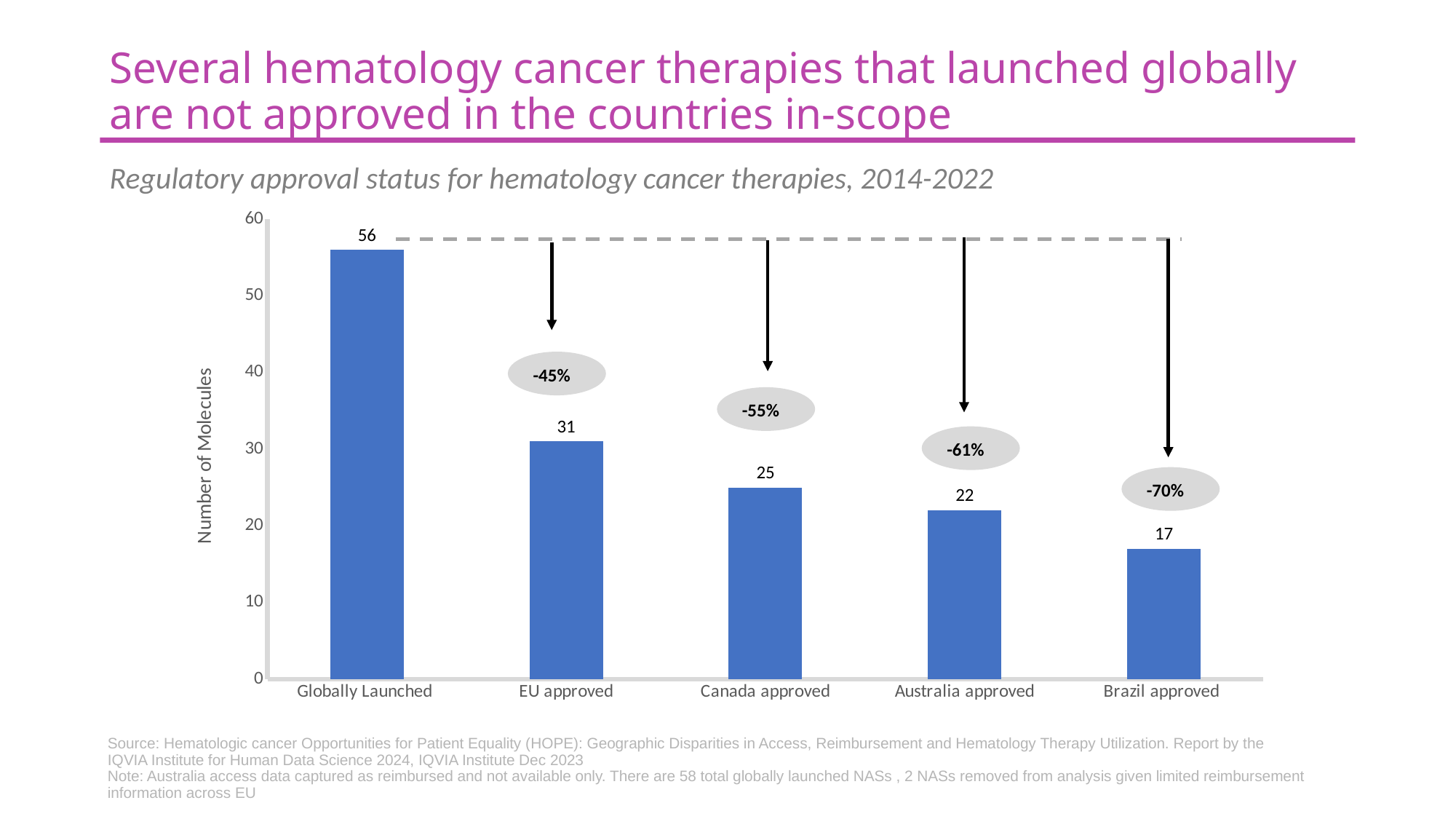
What is the number of molecules for Globally Launched? 56 Which category has the lowest number of molecules? Brazil approved How many categories are shown on the x axis? 5 What is the number of molecules for Canada approved? 25 Which category has the highest number of molecules? Globally Launched Do the values rise or fall from left to right along the x axis? Fall What is the difference in number of molecules between Australia approved and Brazil approved? 5 Which has more molecules, EU approved or Canada approved? EU approved What is the difference in number of molecules between Globally Launched and EU approved? 25 What percentage reduction is shown in the bubble above Australia approved? -61% What is the number of molecules for Brazil approved? 17 What kind of chart is shown on the slide? Bar chart